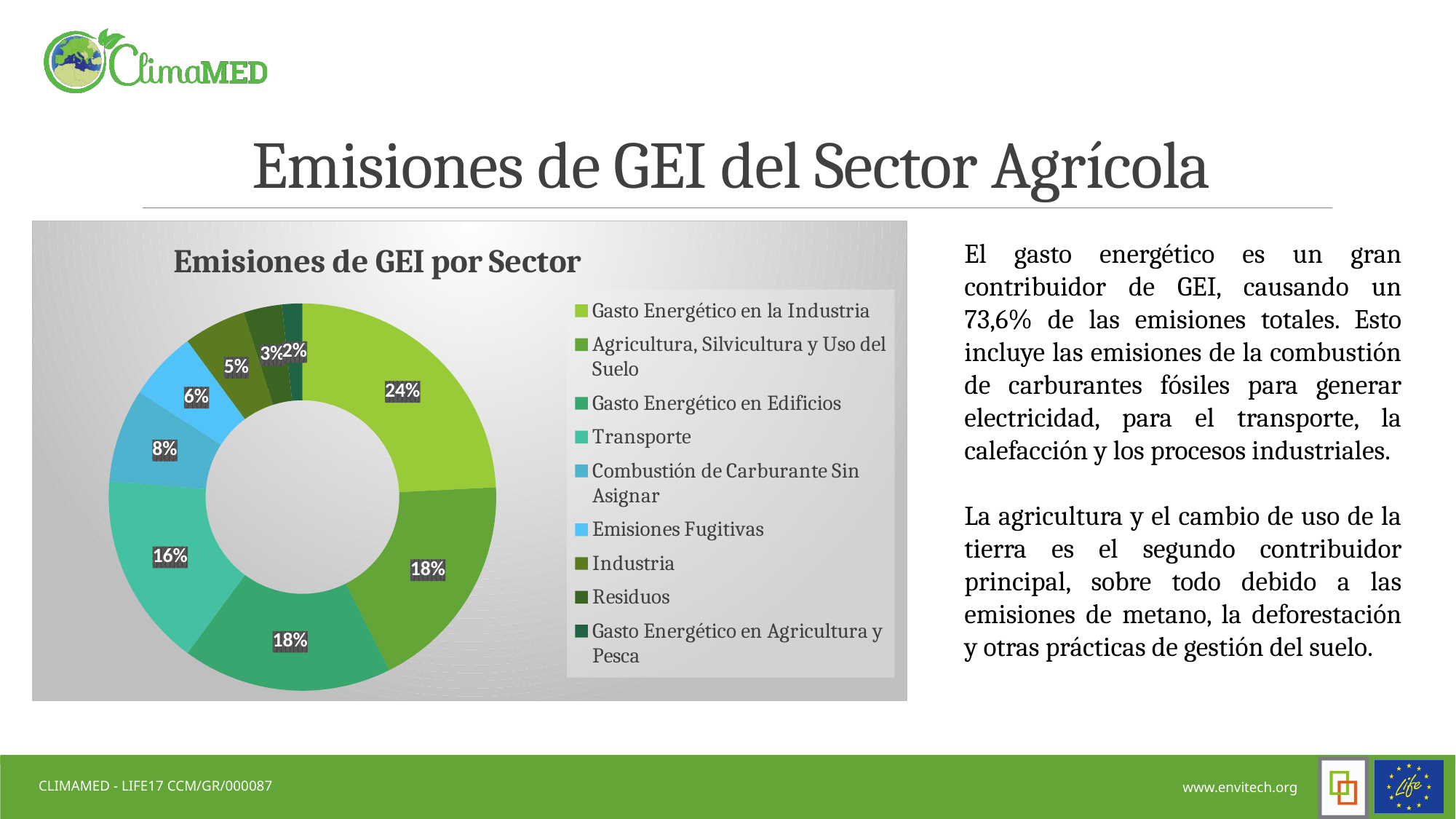
Which sector has the largest share of emissions? Gasto Energético en la Industria What share of emissions does Gasto Energético en la Industria account for? 24% What is the combined share of Agricultura, Silvicultura y Uso del Suelo and Gasto Energético en Edificios? 36% Which is larger, the share for Combustión de Carburante Sin Asignar or the share for Industria? Combustión de Carburante Sin Asignar Which sector has the smallest share of emissions? Gasto Energético en Agricultura y Pesca What is the title of the chart? Emisiones de GEI por Sector What is the difference between the shares of Gasto Energético en la Industria and Transporte? 8% How many sectors does the chart legend list? 9 What share of emissions does Residuos account for? 3% What kind of chart is shown on the slide? Doughnut (pie) chart What share of emissions does Transporte account for? 16% What share of emissions does Emisiones Fugitivas account for? 6%